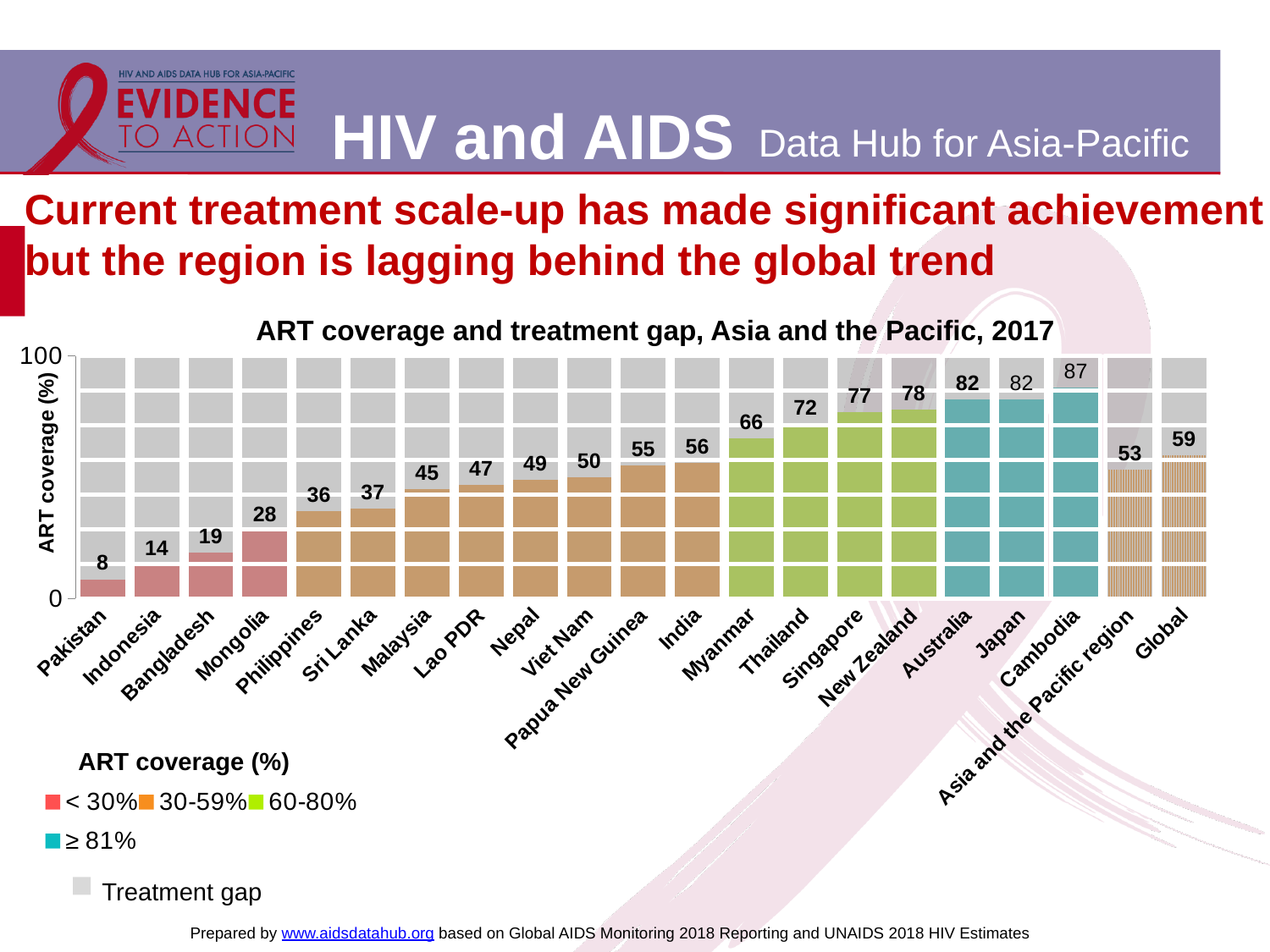
What type of chart is shown on the slide? Stacked bar chart Which country has the lowest ART coverage on the chart? Pakistan What is the ART coverage value shown for Pakistan? 8 What is the ART coverage value shown for Global? 59 Which country has the highest ART coverage on the chart? Cambodia What is the difference between the Global ART coverage and the Asia and the Pacific region ART coverage? 6 What is the title of the chart? ART coverage and treatment gap, Asia and the Pacific, 2017 What is the ART coverage value shown for the Asia and the Pacific region? 53 What is the ART coverage value shown for Cambodia? 87 How many entries does the legend list? 5 Which has higher ART coverage, Thailand or Myanmar? Thailand How many categories (countries and regions) are shown on the x axis of the chart? 21